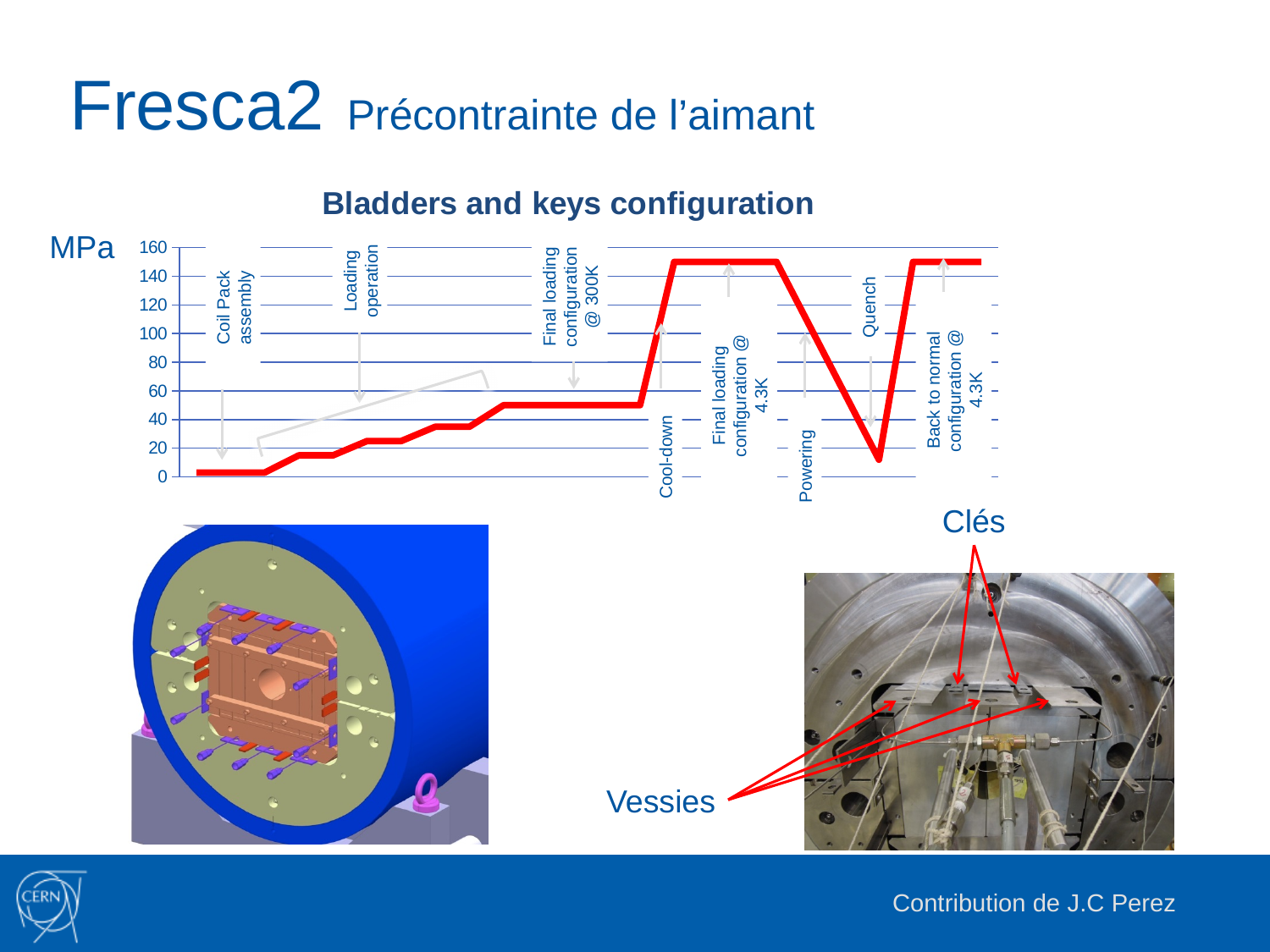
Does the value rise or fall during the Powering stage? fall Is the lowest value reached during the Powering stage greater or less than 40? less Is the value at the Final loading configuration @ 300K stage greater or less than 40? greater Is the value at the Final loading configuration @ 4.3K stage greater or less than 100? greater Which is larger, the value at Final loading configuration @ 4.3K or at Final loading configuration @ 300K? Final loading configuration @ 4.3K How many labelled stages are marked along the chart? 8 What unit is shown on the vertical axis of the chart? MPa Does the value rise or fall during the Cool-down stage? rise What kind of chart is shown on the slide? line chart What is the title of the chart? Bladders and keys configuration